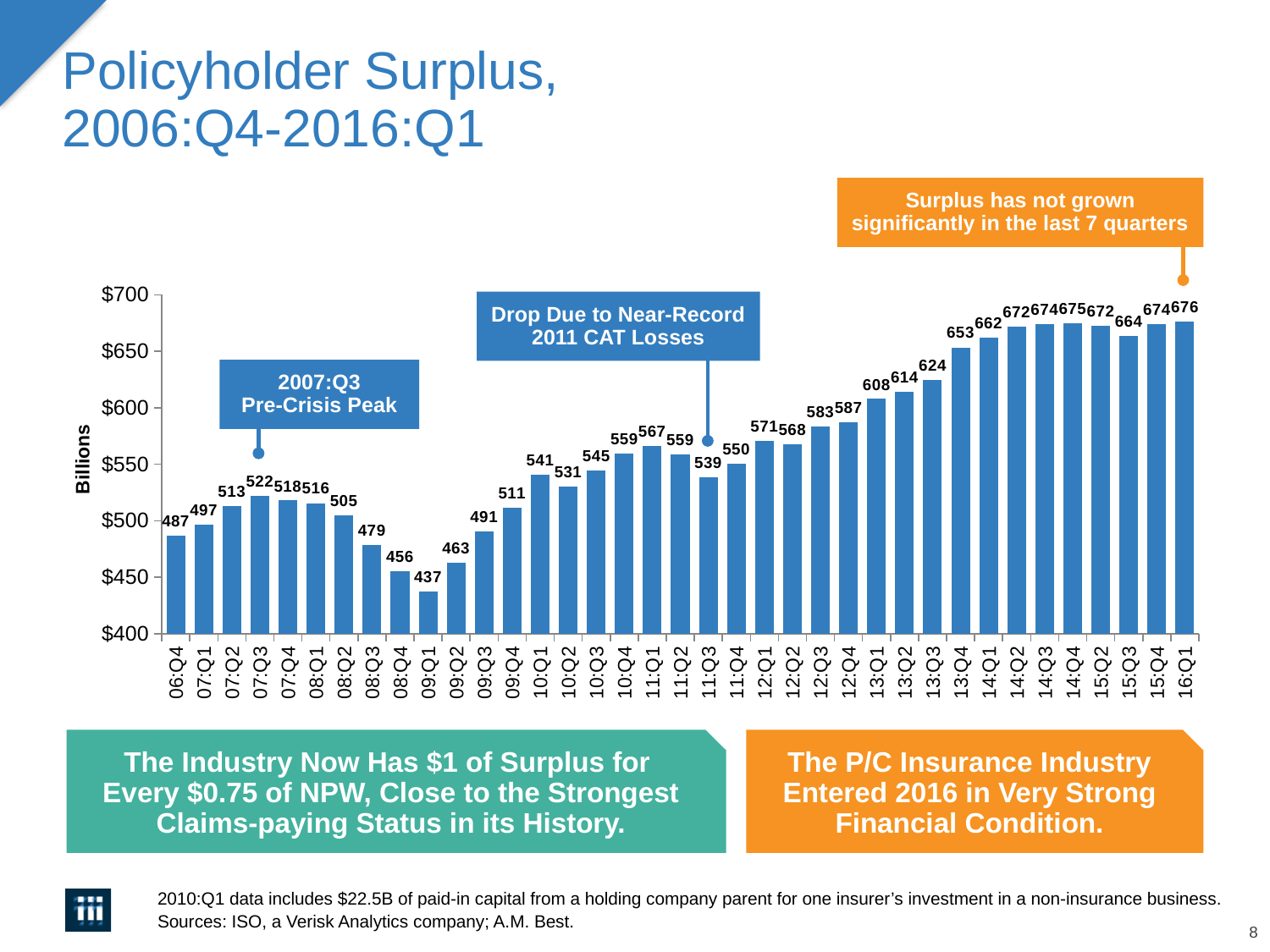
Is the value for 13:Q1 greater or less than $600? greater Do the values rise or fall from 09:Q1 to 11:Q1? rise What is the policyholder surplus value for 09:Q1? 437 Which quarter has the highest policyholder surplus? 16:Q1 Which quarter has the lowest policyholder surplus? 09:Q1 What is the difference between the surplus in 07:Q3 and in 09:Q1? 85 What is the policyholder surplus value for 11:Q3? 539 What kind of chart is shown on the slide? bar chart According to the callout on the chart, what caused the drop in 2011? Near-Record 2011 CAT Losses Which is larger, the surplus in 10:Q1 or in 10:Q2? 10:Q1 What is the label on the vertical axis of the chart? Billions What is the policyholder surplus value for 07:Q3? 522